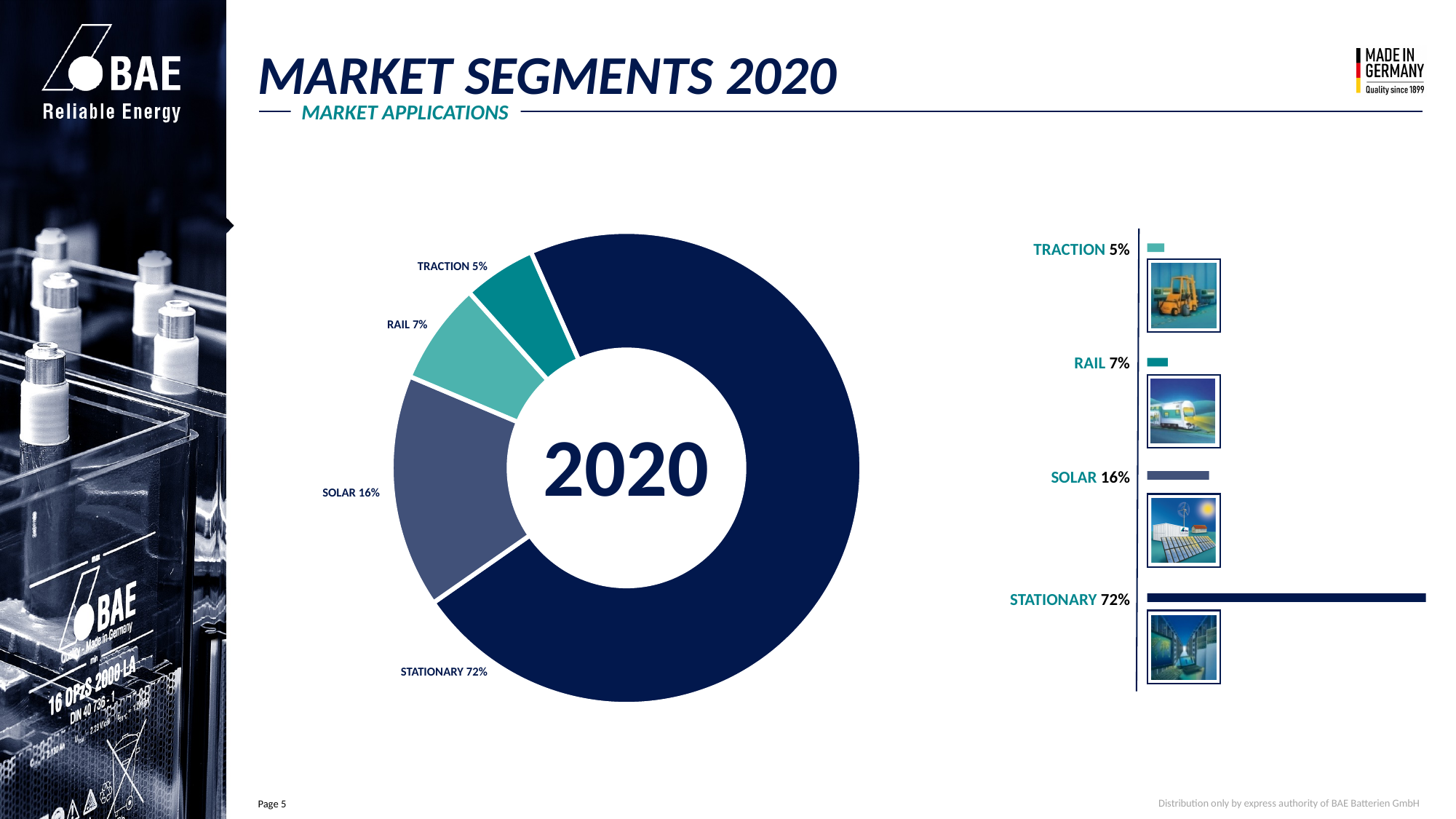
In the donut chart, which segment has the smallest share? TRACTION In the donut chart, what share does SOLAR have? 16% What kind of chart is shown on the right side of the slide next to the pictures? Bar chart In the donut chart, which is larger, RAIL or TRACTION? RAIL In the donut chart, what share does RAIL have? 7% In the donut chart, what share does STATIONARY have? 72% In the donut chart, what is the difference in percentage points between STATIONARY and SOLAR? 56 What kind of chart is the chart on the left of the slide? Donut (pie) chart How many segments does the donut chart have? 4 In the donut chart, what share does TRACTION have? 5% What year is printed in the centre of the donut chart? 2020 In the donut chart, which segment has the largest share? STATIONARY